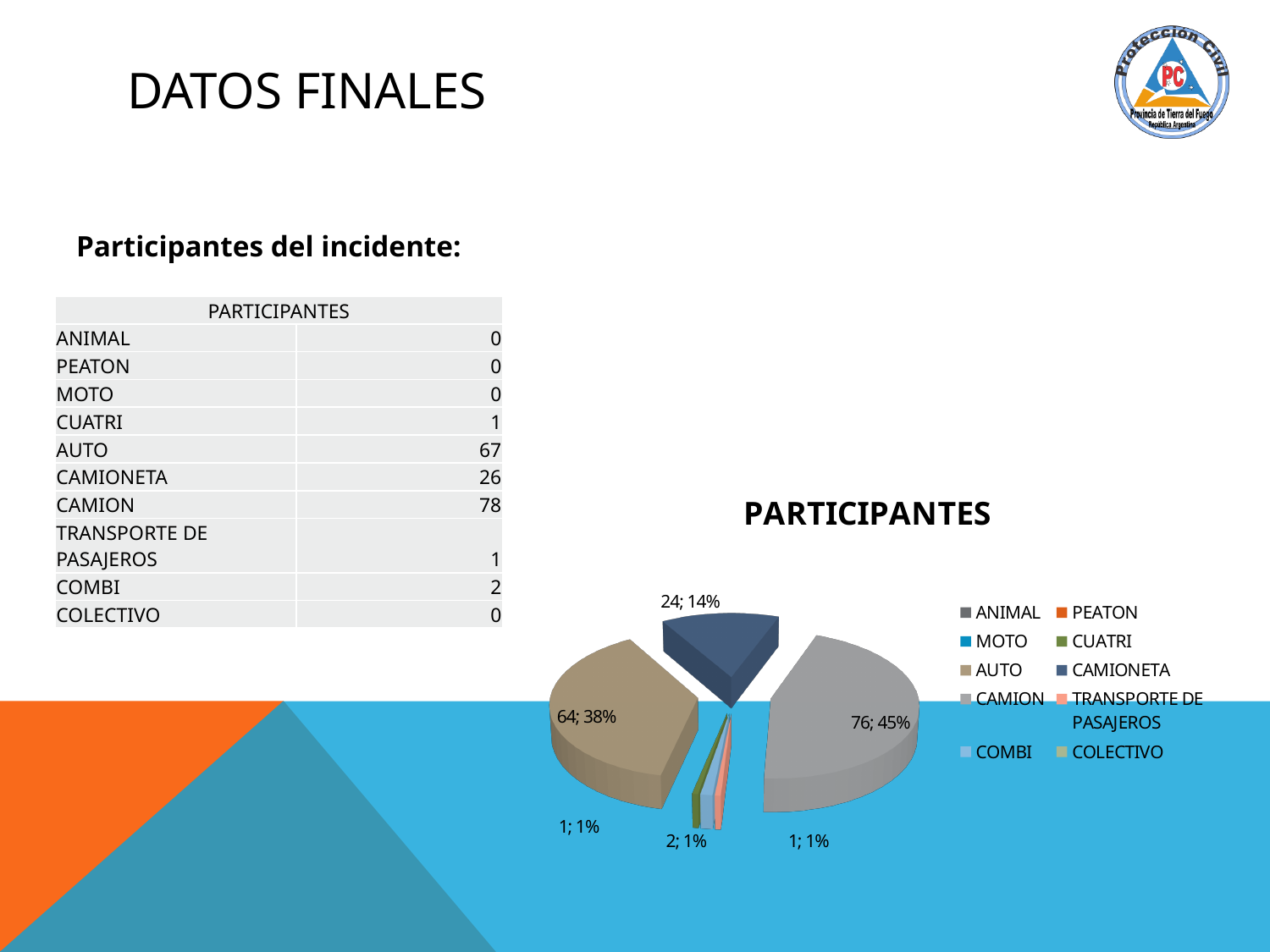
In the PARTICIPANTES pie chart, what share of the pie does CAMIONETA represent? 14% In the PARTICIPANTES pie chart, what value is shown for CAMIONETA? 24 In the PARTICIPANTES pie chart, what share of the pie does AUTO represent? 38% How many entries does the legend of the PARTICIPANTES pie chart list? 10 In the PARTICIPANTES pie chart, what share of the pie does CAMION represent? 45% What kind of chart is shown under the title PARTICIPANTES? pie chart What is the title of the pie chart on the slide? PARTICIPANTES In the PARTICIPANTES pie chart, which is larger, AUTO or CAMION? CAMION In the PARTICIPANTES pie chart, what is the difference between the values for CAMION and AUTO? 12 In the PARTICIPANTES pie chart, what value is shown for CAMION? 76 In the PARTICIPANTES pie chart, what value is shown for AUTO? 64 Which category has the largest slice in the PARTICIPANTES pie chart? CAMION